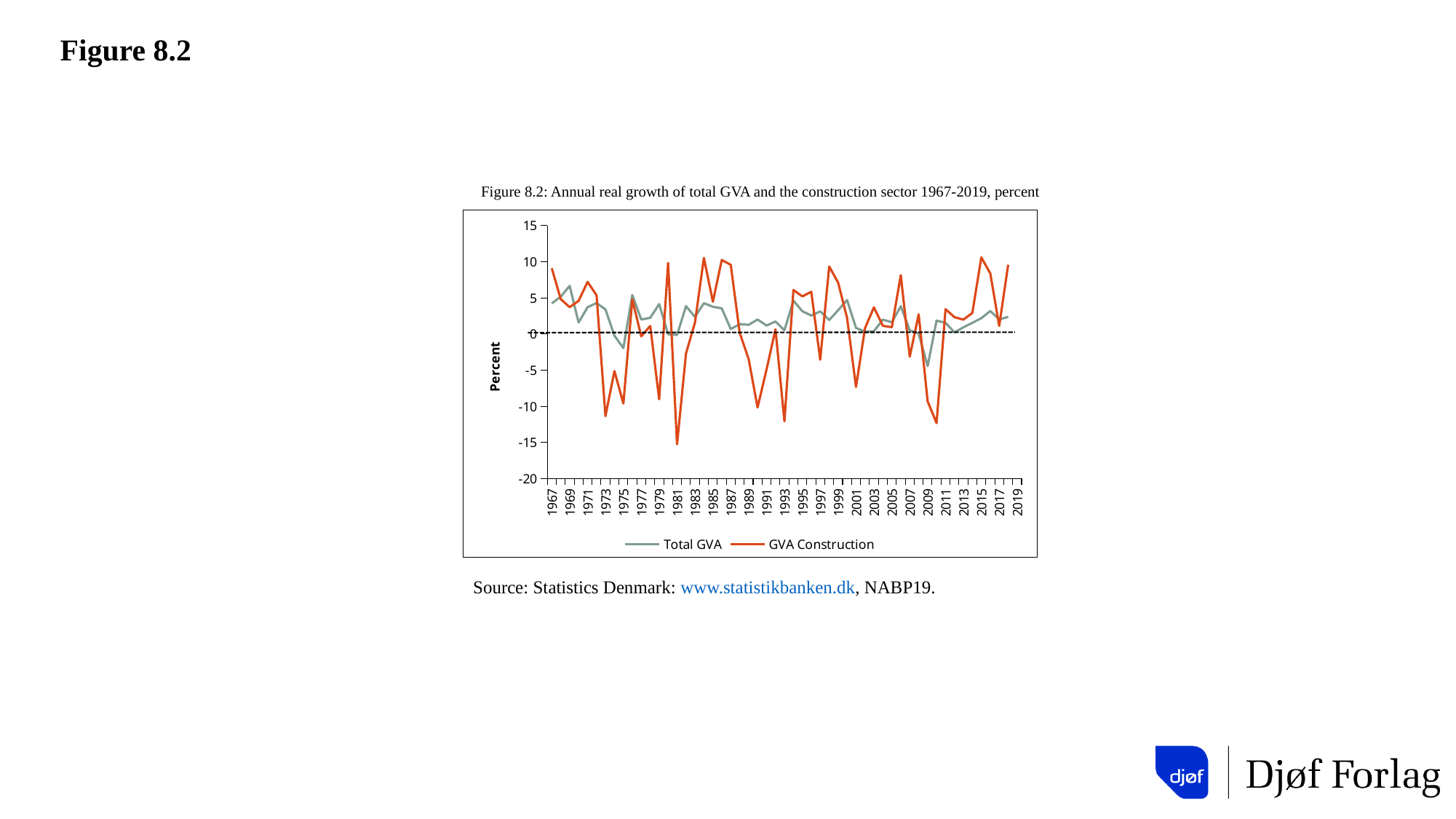
What are the two series named in the legend? Total GVA and GVA Construction Is the value for GVA Construction in 1981 greater or less than -10? less What kind of chart is shown on the slide? Line chart Is the value for GVA Construction in 2015 greater or less than 5? greater How many series does the legend list? 2 In which year does the GVA Construction series reach its lowest value? 1981 In 1981, which series has the higher value, Total GVA or GVA Construction? Total GVA Is the value for Total GVA in 2009 greater or less than 0? less What is the label on the vertical axis? Percent